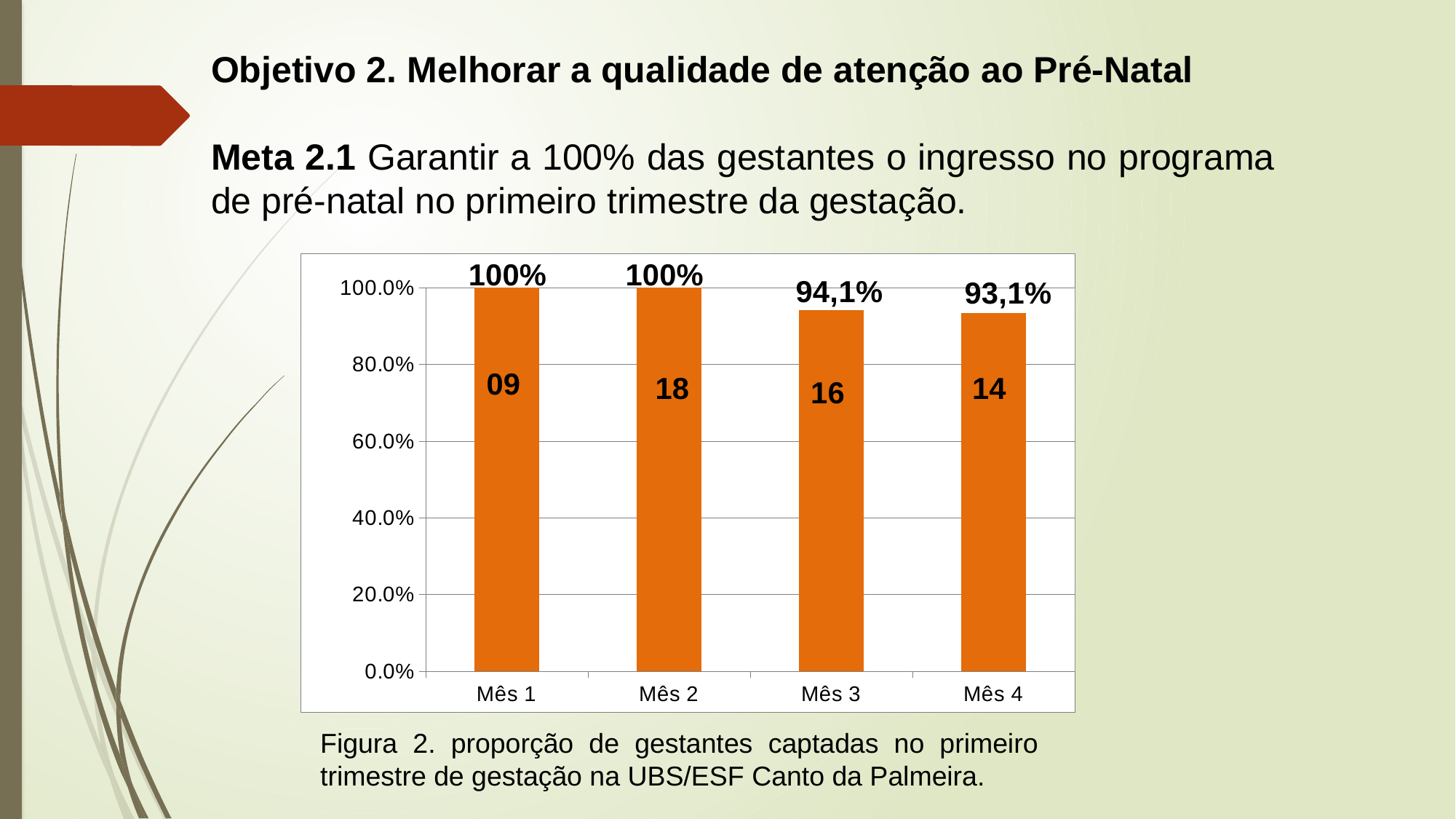
Which month has the lowest percentage? Mês 4 Do the percentages rise or fall from Mês 2 to Mês 4? Fall Which is larger, the percentage for Mês 2 or for Mês 3? Mês 2 What kind of chart is shown on the slide? Bar chart How many months (categories) are shown on the x axis? 4 What percentage is shown for Mês 3? 94,1% What percentage is shown for Mês 4? 93,1% What colour are the bars in the chart? Orange Is the value for Mês 4 greater or less than 80.0%? greater What is the difference in percentage points between Mês 3 and Mês 4? 1,0 What number is printed inside the bar for Mês 2? 18 What number is printed inside the bar for Mês 1? 09